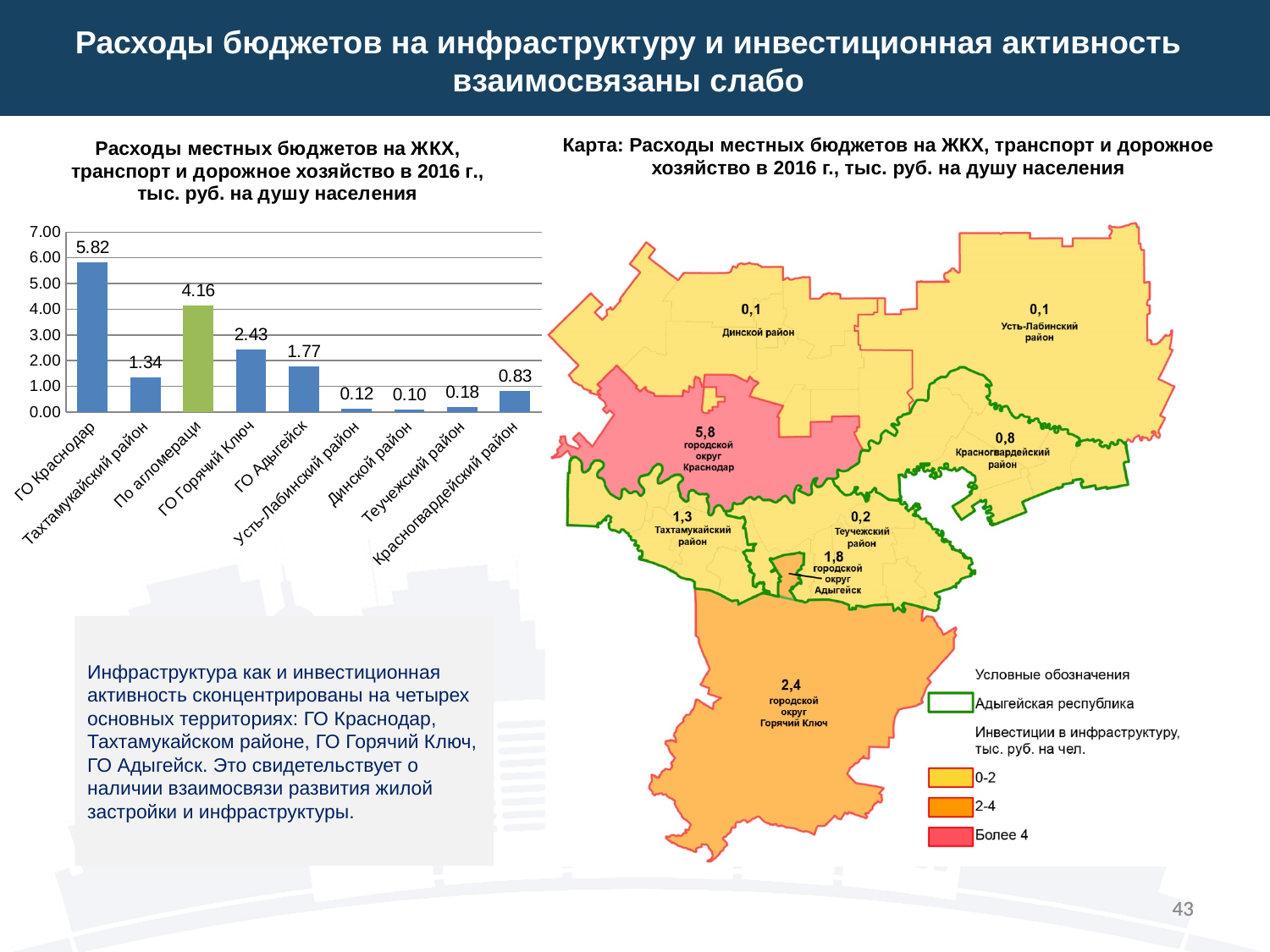
In the bar chart, which category has the lowest value? Динской район In the bar chart, what is the value for ГО Краснодар? 5.82 In the bar chart, what is the value for По агломераци? 4.16 In the bar chart, which category's bar is coloured green instead of blue? По агломераци In the bar chart, which category has the highest value? ГО Краснодар In the bar chart, what is the value for Красногвардейский район? 0.83 In the bar chart, is the value for ГО Адыгейск greater or less than 2.00? less In the bar chart, which is larger: the value for Тахтамукайский район or the value for ГО Адыгейск? ГО Адыгейск In the bar chart, what is the value for ГО Горячий Ключ? 2.43 How many categories are shown in the bar chart? 9 What type of chart is shown on the left of the slide? bar chart In the bar chart, what is the difference between the values for ГО Краснодар and ГО Горячий Ключ? 3.39